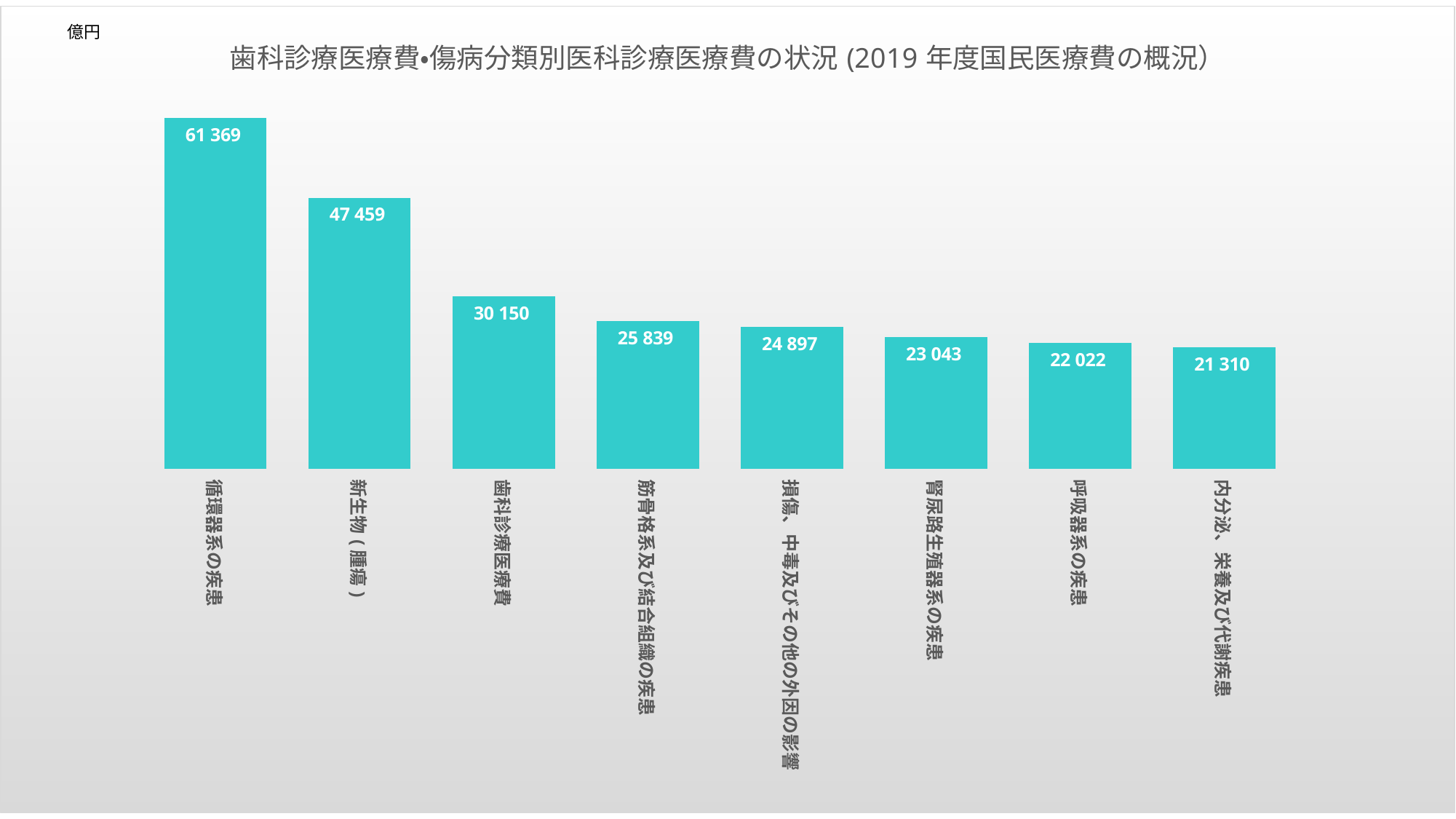
What is the difference between the values for 循環器系の疾患 and 新生物（腫瘍）? 13 910 What is the difference between the values for 歯科診療医療費 and 筋骨格系及び結合組織の疾患? 4 311 What is the value for 歯科診療医療費? 30 150 Which category has the highest value? 循環器系の疾患 Which category has the lowest value? 内分泌、栄養及び代謝疾患 What is the value for 循環器系の疾患? 61 369 What is the value for 内分泌、栄養及び代謝疾患? 21 310 What kind of chart is shown on the slide? Bar chart What is the value for 呼吸器系の疾患? 22 022 Which is larger, the value for 新生物（腫瘍） or the value for 歯科診療医療費? 新生物（腫瘍） How many categories are shown in the chart? 8 Do the values rise or fall from left to right along the x axis? Fall